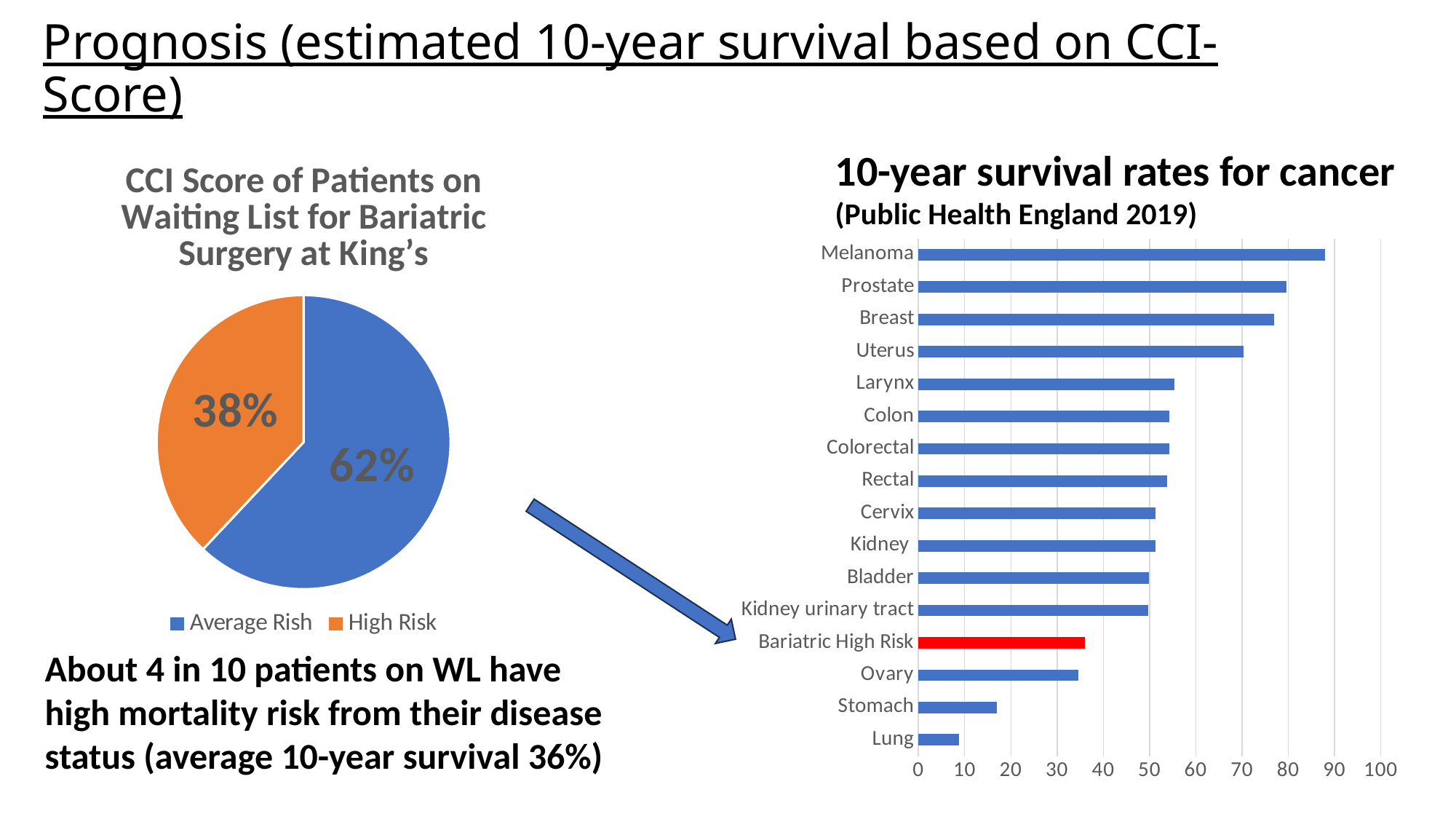
On the pie chart on the left, which slice is larger, Average Rish or High Risk? Average Rish On the pie chart on the left, what percentage of patients are in the 'Average Rish' category? 62% On the '10-year survival rates for cancer' chart, which category has the lowest 10-year survival rate? Lung On the '10-year survival rates for cancer' chart, how many categories are plotted? 16 On the '10-year survival rates for cancer' chart, is the value for Stomach greater or less than 20? less What kind of chart is the '10-year survival rates for cancer' chart on the right? Bar chart On the pie chart on the left, what colour is the High Risk slice? Orange On the '10-year survival rates for cancer' chart, which cancer has the highest 10-year survival rate? Melanoma On the pie chart on the left, how many entries does the legend list? 2 On the pie chart titled 'CCI Score of Patients on Waiting List for Bariatric Surgery at King's', what percentage of patients are High Risk? 38% On the '10-year survival rates for cancer' chart, is the value for Melanoma greater or less than 80? greater On the '10-year survival rates for cancer' chart, which bar is shown in red rather than blue? Bariatric High Risk